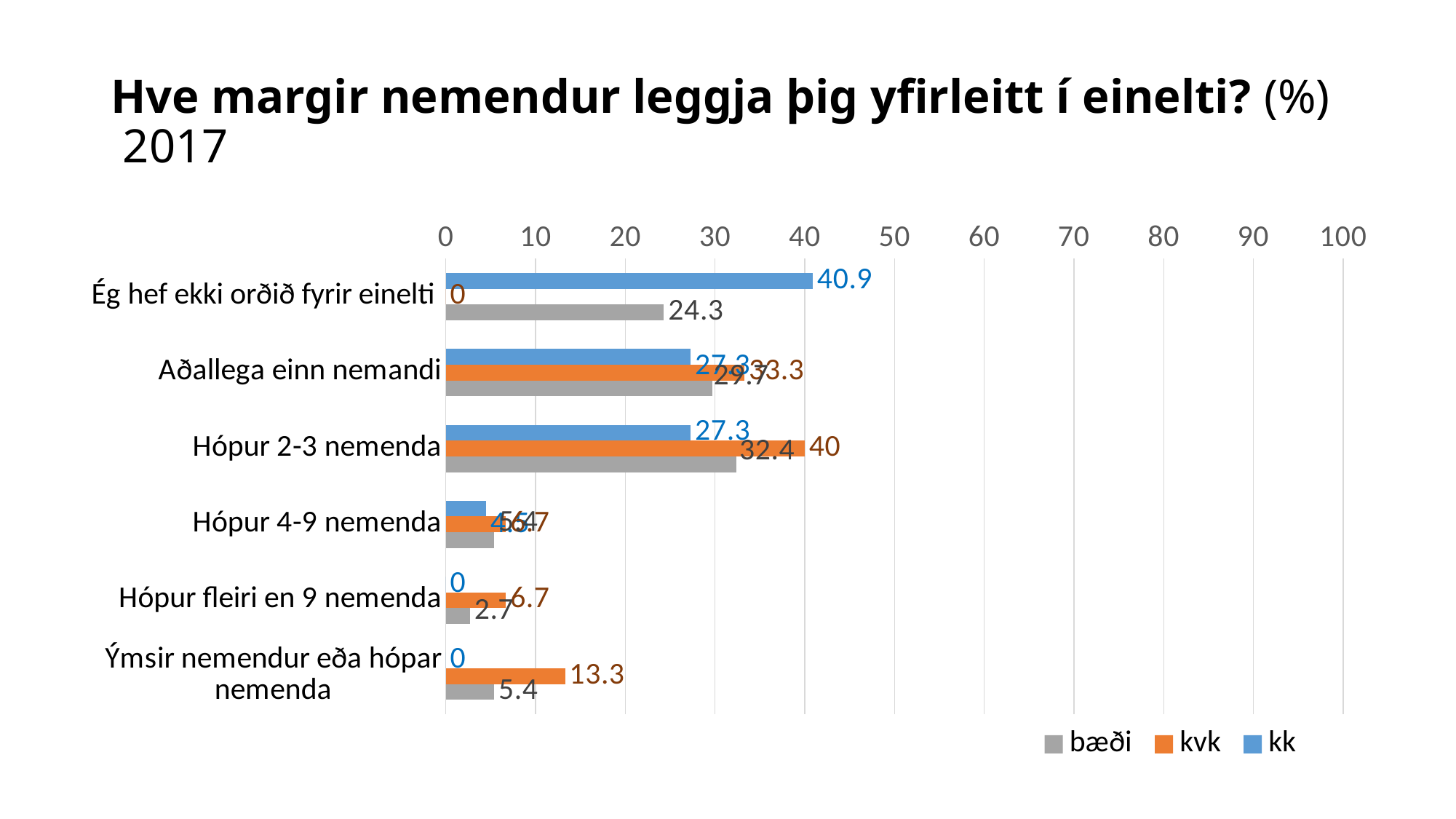
In the category "Ýmsir nemendur eða hópar nemenda", which is larger: the kvk value or the bæði value? kvk What is the value for kvk in the category "Ýmsir nemendur eða hópar nemenda"? 13.3 What is the value for bæði in the category "Ég hef ekki orðið fyrir einelti"? 24.3 What is the value for kvk in the category "Hópur 2-3 nemenda"? 40 How many series does the legend list? 3 What is the value for kk in the category "Hópur fleiri en 9 nemenda"? 0 Which category has the highest value for the kvk series? Hópur 2-3 nemenda How many categories are shown on the chart? 6 What is the value for kk in the category "Ég hef ekki orðið fyrir einelti"? 40.9 What is the difference between the kk value and the bæði value for "Ég hef ekki orðið fyrir einelti"? 16.6 Which category has the highest value for the kk series? Ég hef ekki orðið fyrir einelti Is the kk value for "Hópur 4-9 nemenda" greater or less than 10? less